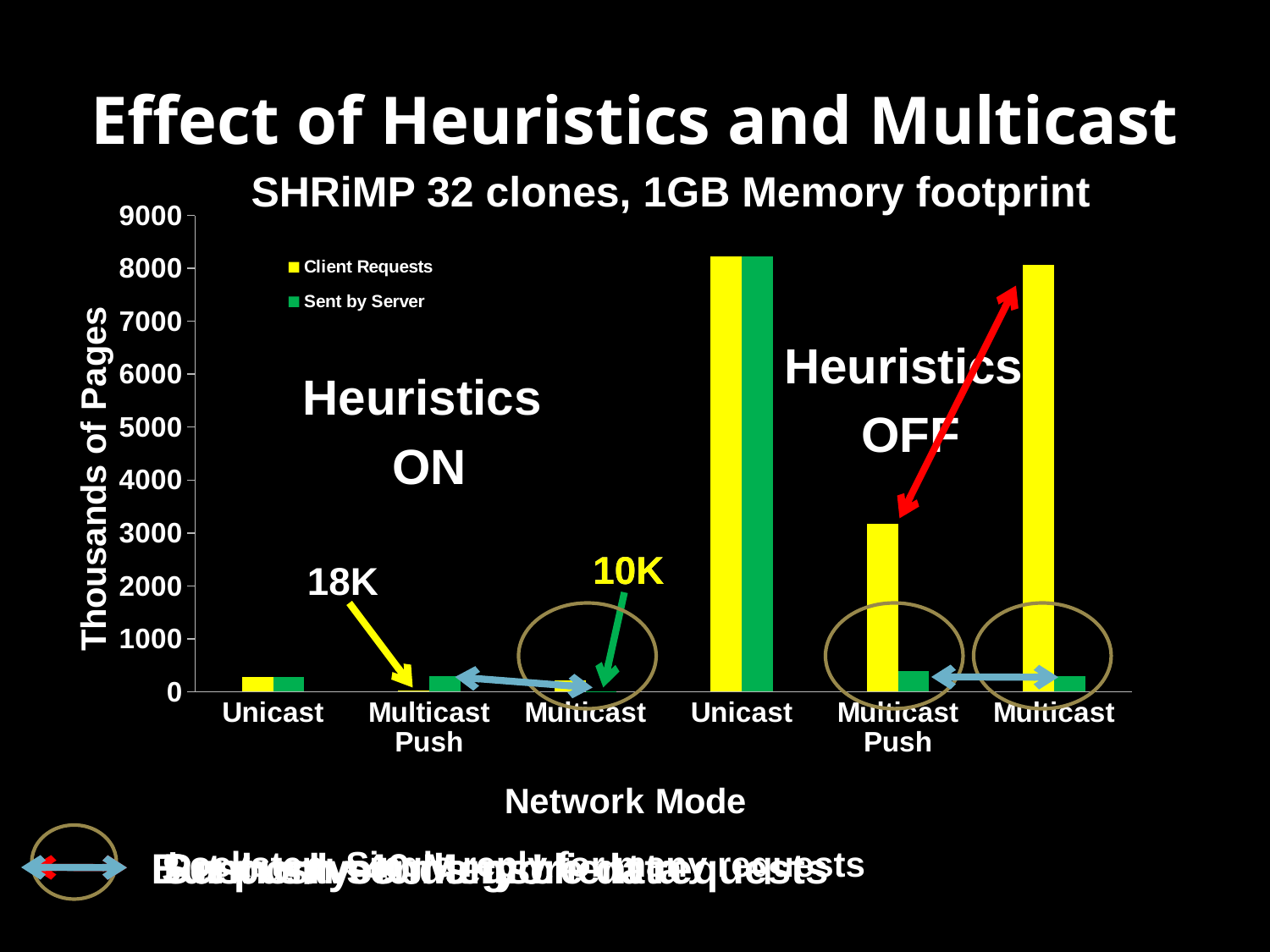
Among the Heuristics OFF categories, which has the lowest Client Requests value? Multicast Push How many categories are shown along the x axis of the chart? 6 What is the title of the chart's y axis? Thousands of Pages How many series does the chart legend list? 2 Under Heuristics OFF, which has the larger Client Requests value: Unicast or Multicast Push? Unicast What kind of chart is shown on the slide? bar chart Under Heuristics OFF, which has the larger Sent by Server value: Unicast or Multicast? Unicast What are the two series named in the chart legend? Client Requests and Sent by Server Is the Sent by Server value for Multicast under Heuristics OFF greater or less than 1000? less Is the Client Requests value for Multicast Push under Heuristics OFF greater or less than 3000? greater Is the Client Requests value for Unicast under Heuristics ON greater or less than 1000? less